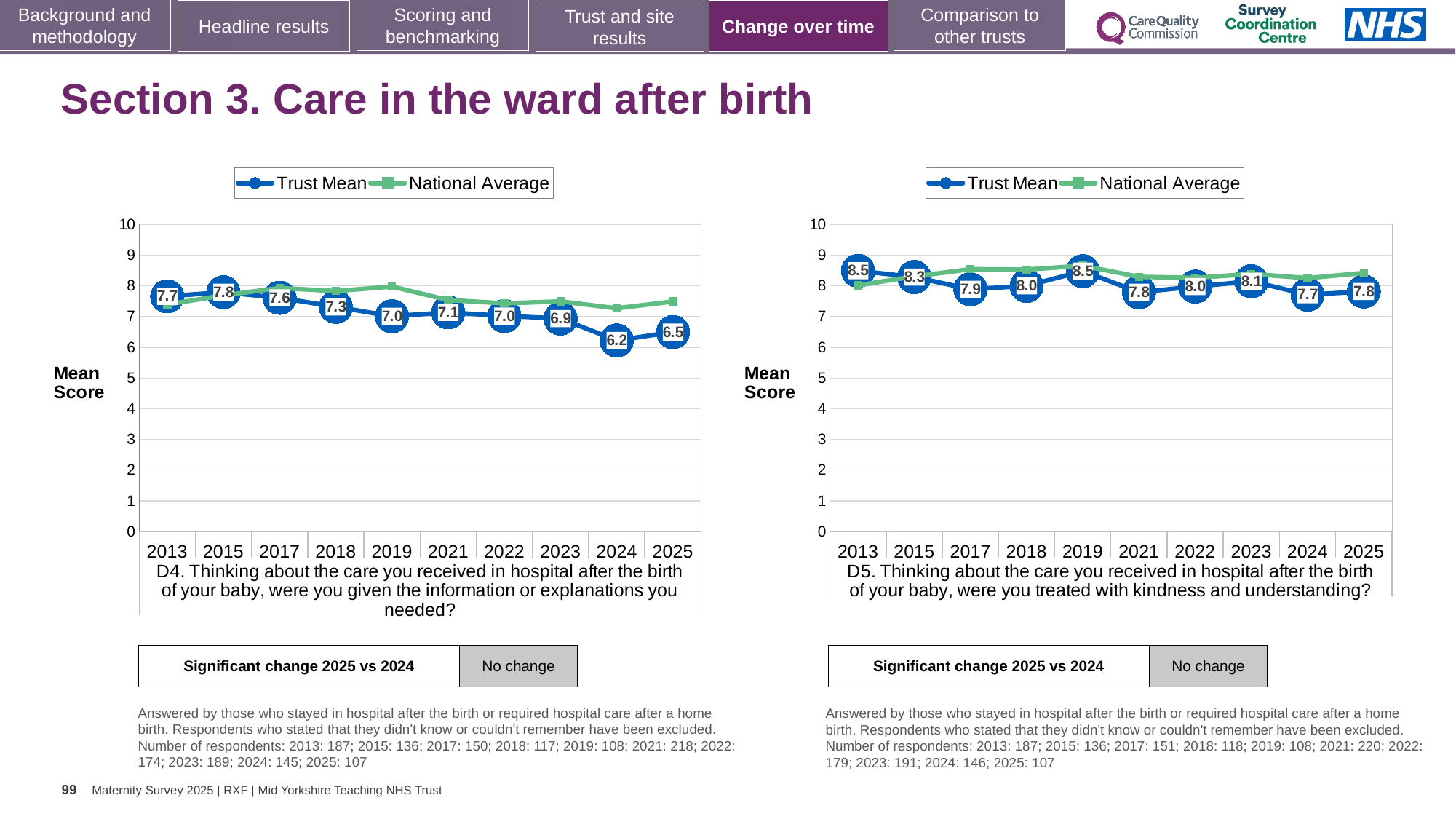
In the right chart (D5), what is the Trust Mean score for 2021? 7.8 How many series does the legend of the right chart (D5) list? 2 In the left chart (D4), is the National Average value for 2024 greater or less than 7? greater How many years are plotted on the x axis of the left chart (D4)? 10 In the left chart (D4), what is the difference between the Trust Mean scores for 2013 and 2025? 1.2 In the left chart (D4), which year has the highest Trust Mean score? 2015 In the right chart (D5), which year has the lowest Trust Mean score? 2024 In the left chart (D4), what is the Trust Mean score for 2024? 6.2 In the left chart (D4), which year has the lowest Trust Mean score? 2024 In the right chart (D5), is the Trust Mean score higher in 2013 or in 2017? 2013 In the right chart (D5), what is the difference between the Trust Mean scores for 2019 and 2024? 0.8 What kind of chart is the left chart (D4)? Line chart